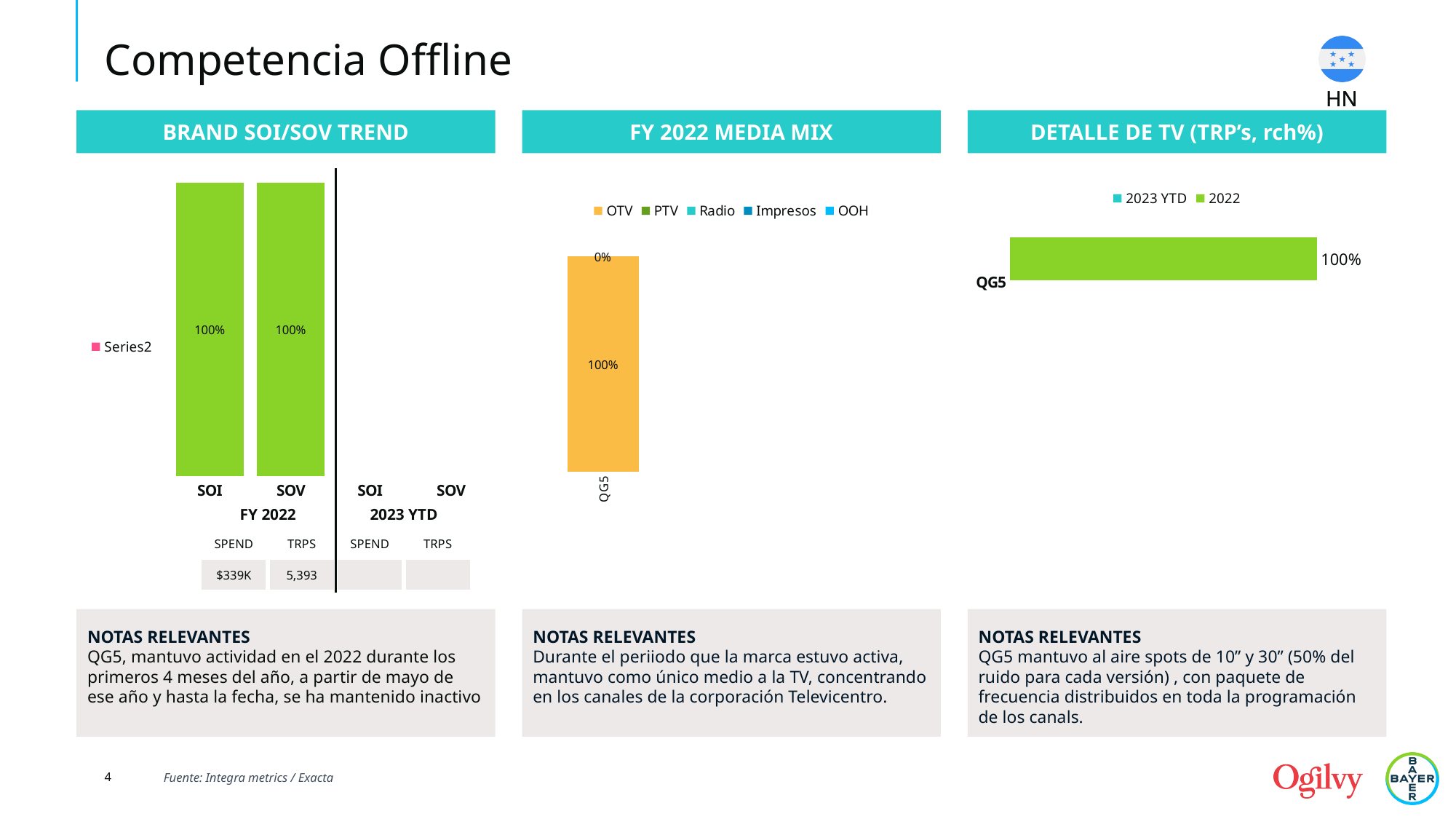
What kind of chart is the FY 2022 MEDIA MIX chart? Bar chart How many categories are shown on the x axis of the FY 2022 MEDIA MIX chart? 1 In the BRAND SOI/SOV TREND chart, what is the value of the SOV bar for FY 2022? 100% What kind of chart is the DETALLE DE TV (TRP's, rch%) chart? Bar chart In the FY 2022 MEDIA MIX chart, which medium accounts for the entire bar for QG5? OTV In the DETALLE DE TV (TRP's, rch%) chart, what is the value shown for QG5 in 2022? 100% In the BRAND SOI/SOV TREND chart, what is the difference between the SOI and SOV values for FY 2022? 0% In the BRAND SOI/SOV TREND chart, what is the value of the SOI bar for FY 2022? 100% How many series does the legend of the FY 2022 MEDIA MIX chart list? 5 In the FY 2022 MEDIA MIX chart, what is the value of the OTV segment for QG5? 100% What is the legend entry shown in the BRAND SOI/SOV TREND chart? Series2 How many series does the legend of the DETALLE DE TV (TRP's, rch%) chart list? 2